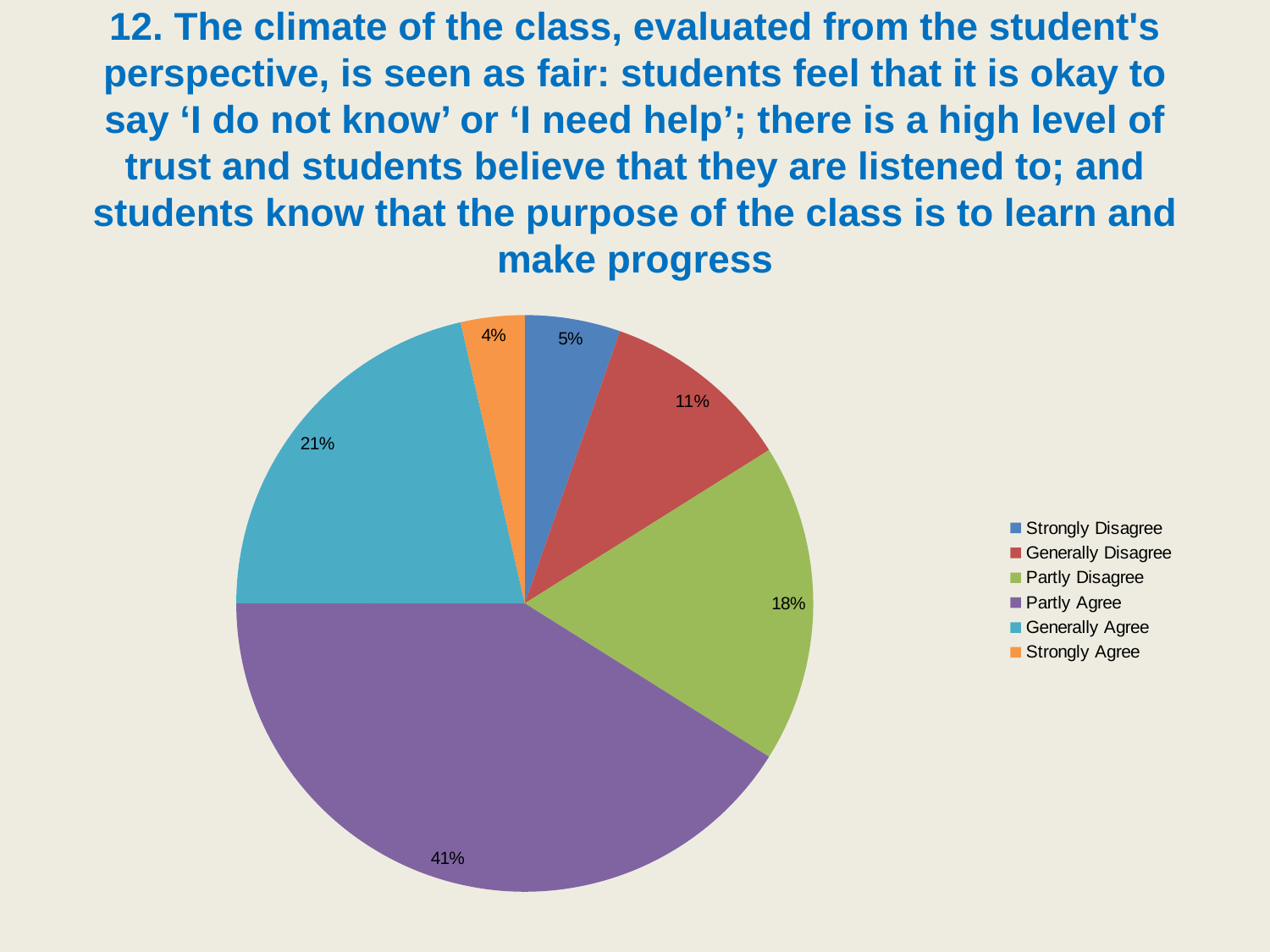
What is the combined share of Generally Agree and Strongly Agree? 25% What percentage of the pie is Strongly Disagree? 5% What percentage of the pie is Partly Agree? 41% What colour is the Strongly Agree slice? orange How many categories does the legend list? 6 Which is larger, the Generally Disagree slice or the Partly Disagree slice? Partly Disagree What percentage of the pie is Partly Disagree? 18% What percentage of the pie is Generally Agree? 21% Which category has the smallest slice of the pie? Strongly Agree Which category has the largest slice of the pie? Partly Agree What kind of chart is shown on the slide? pie chart What is the difference in percentage points between Partly Agree and Generally Agree? 20